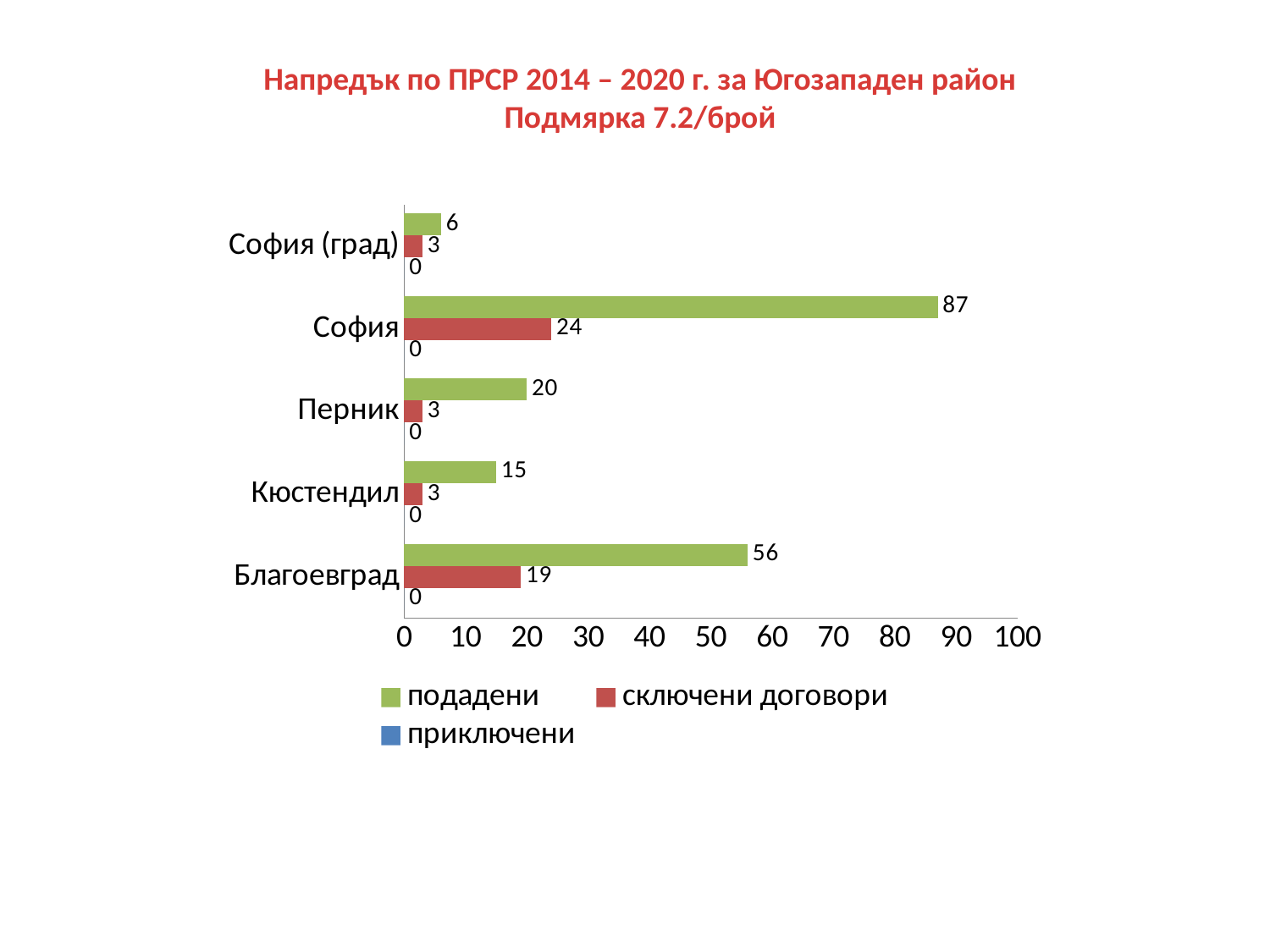
Which category has the lowest value for подадени? София (град) What is the value of подадени for Кюстендил? 15 What is the difference between подадени and сключени договори for Благоевград? 37 What is the value of приключени for Перник? 0 What colour represents the series сключени договори? red How many series does the legend list? 3 What kind of chart is shown on the slide? bar chart What is the value of подадени for София? 87 Which is larger: подадени for Перник or подадени for Кюстендил? Перник What is the value of сключени договори for Благоевград? 19 How many categories are shown on the chart? 5 Which category has the highest value for подадени? София